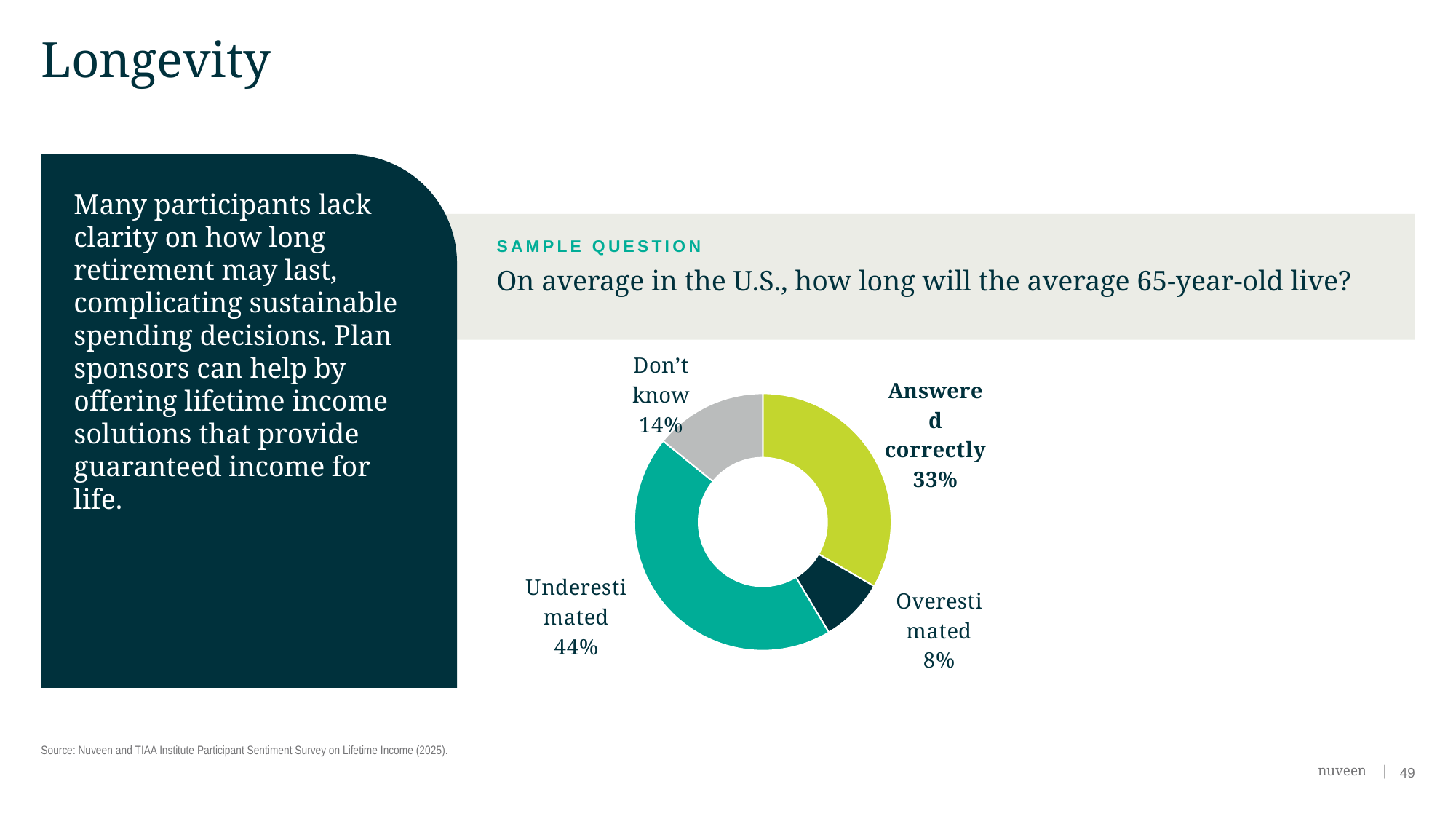
What kind of chart is shown on the slide? Pie chart (donut) What is the difference in percentage points between Don't know and Overestimated? 6 Which response category has the smallest share? Overestimated What sample question is the chart based on? On average in the U.S., how long will the average 65-year-old live? What is the difference in percentage points between Underestimated and Answered correctly? 11 What percentage of participants overestimated? 8% Which response category has the largest share? Underestimated What percentage of participants answered 'Don't know'? 14% Which is larger, the share that answered correctly or the share that said Don't know? Answered correctly What percentage of participants answered correctly? 33% What percentage of participants underestimated how long the average 65-year-old will live? 44% How many response categories are shown in the chart? 4